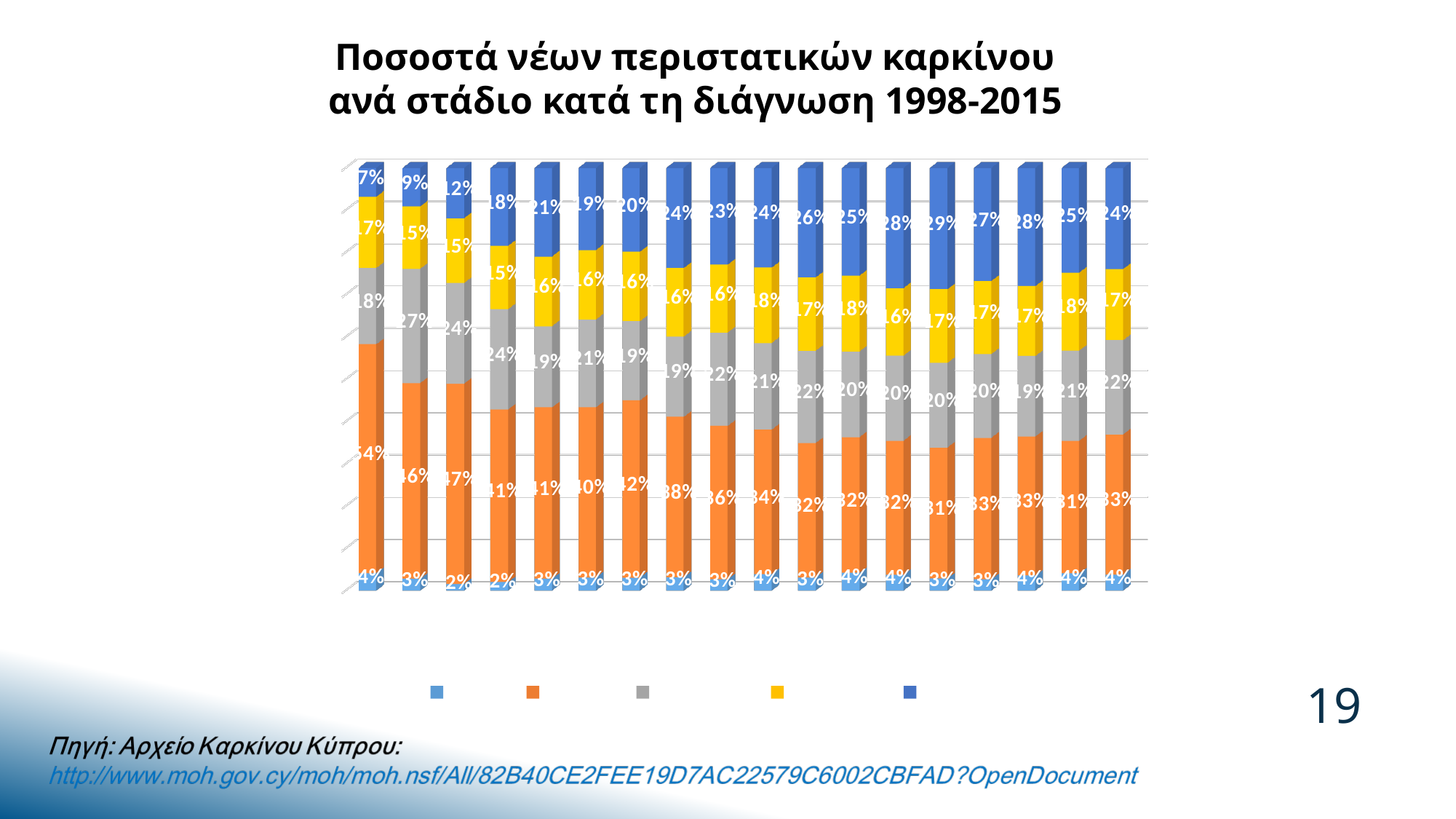
What is the value of the orange segment in the rightmost bar? 33% Which bar has the largest orange segment? The leftmost bar (54%) How many bars (years) are plotted in the chart? 18 What is the title of the chart? Ποσοστά νέων περιστατικών καρκίνου ανά στάδιο κατά τη διάγνωση 1998-2015 What is the value of the light blue (bottom) segment in the leftmost bar? 4% What is the value of the dark blue (top) segment in the rightmost bar? 24% What kind of chart is shown on the slide? Stacked bar chart Does the orange segment generally rise or fall from left to right across the bars? Fall What is the value of the orange segment in the leftmost bar? 54% By how many percentage points does the orange segment of the leftmost bar exceed the orange segment of the rightmost bar? 21 percentage points Does the dark blue (top) segment generally rise or fall from left to right across the bars? Rise How many series does the legend show? 5